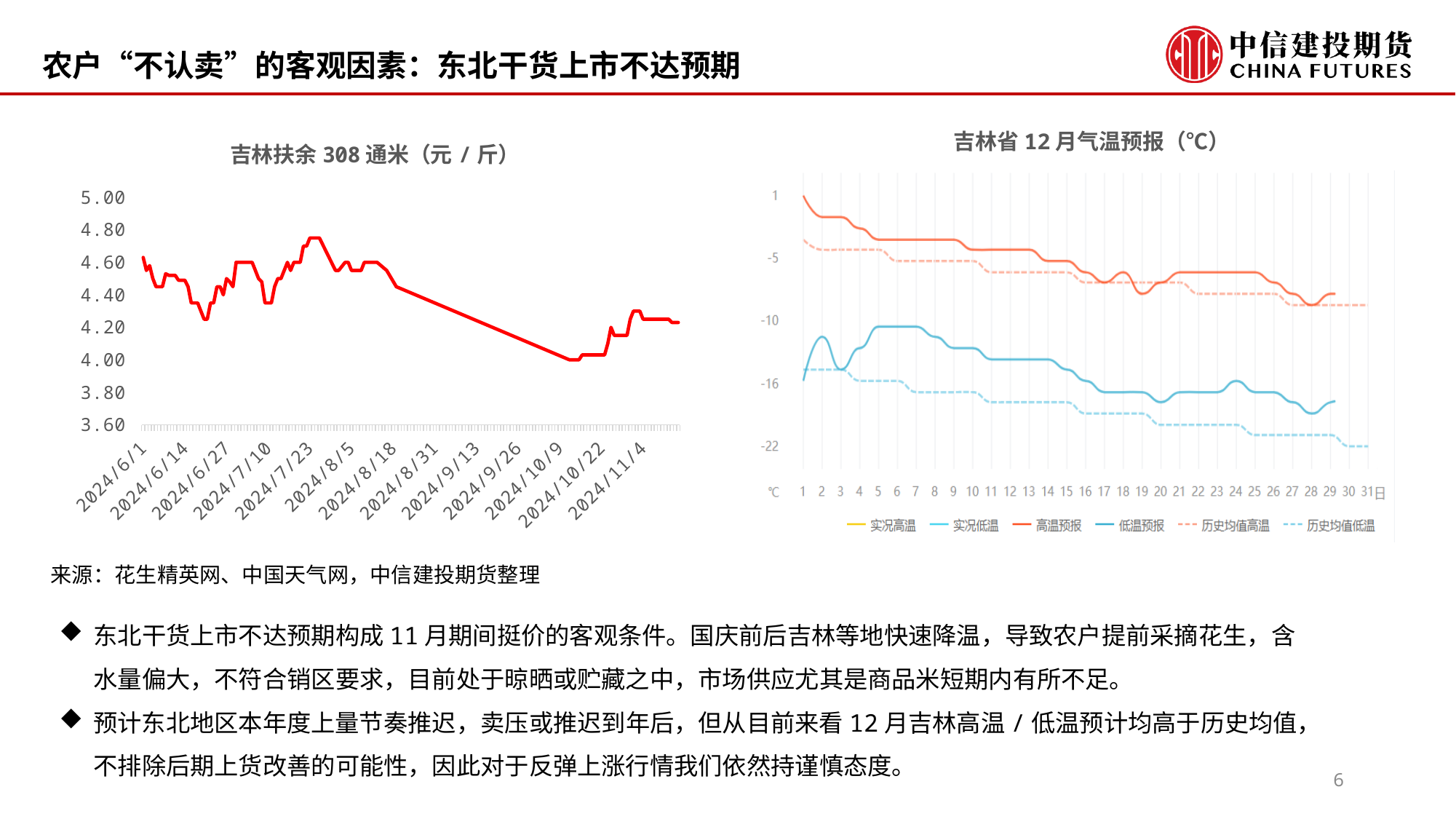
In the left chart (吉林扶余308通米), is the value at 2024/9/26 greater or less than 4.40? less In the right chart (吉林省12月气温预报), does the 历史均值高温 line rise or fall from day 1 to day 31? fall What kind of chart is the right chart titled 吉林省12月气温预报（℃）? line chart What is the unit shown in the title of the left chart? 元/斤 What kind of chart is the left chart titled 吉林扶余308通米（元/斤）? line chart In the left chart (吉林扶余308通米), is the value around 2024/7/23 greater or less than 4.60? greater In the left chart (吉林扶余308通米), does the price overall rise or fall from 2024/6/1 to 2024/11/4? fall In the right chart (吉林省12月气温预报), is the 低温预报 value on day 1 greater or less than -10? less How many series does the legend of the right chart (吉林省12月气温预报) list? 6 In the left chart (吉林扶余308通米), which date has the higher value, 2024/7/23 or 2024/10/9? 2024/7/23 In the right chart (吉林省12月气温预报), on day 10, which series has the higher value, 高温预报 or 历史均值高温? 高温预报